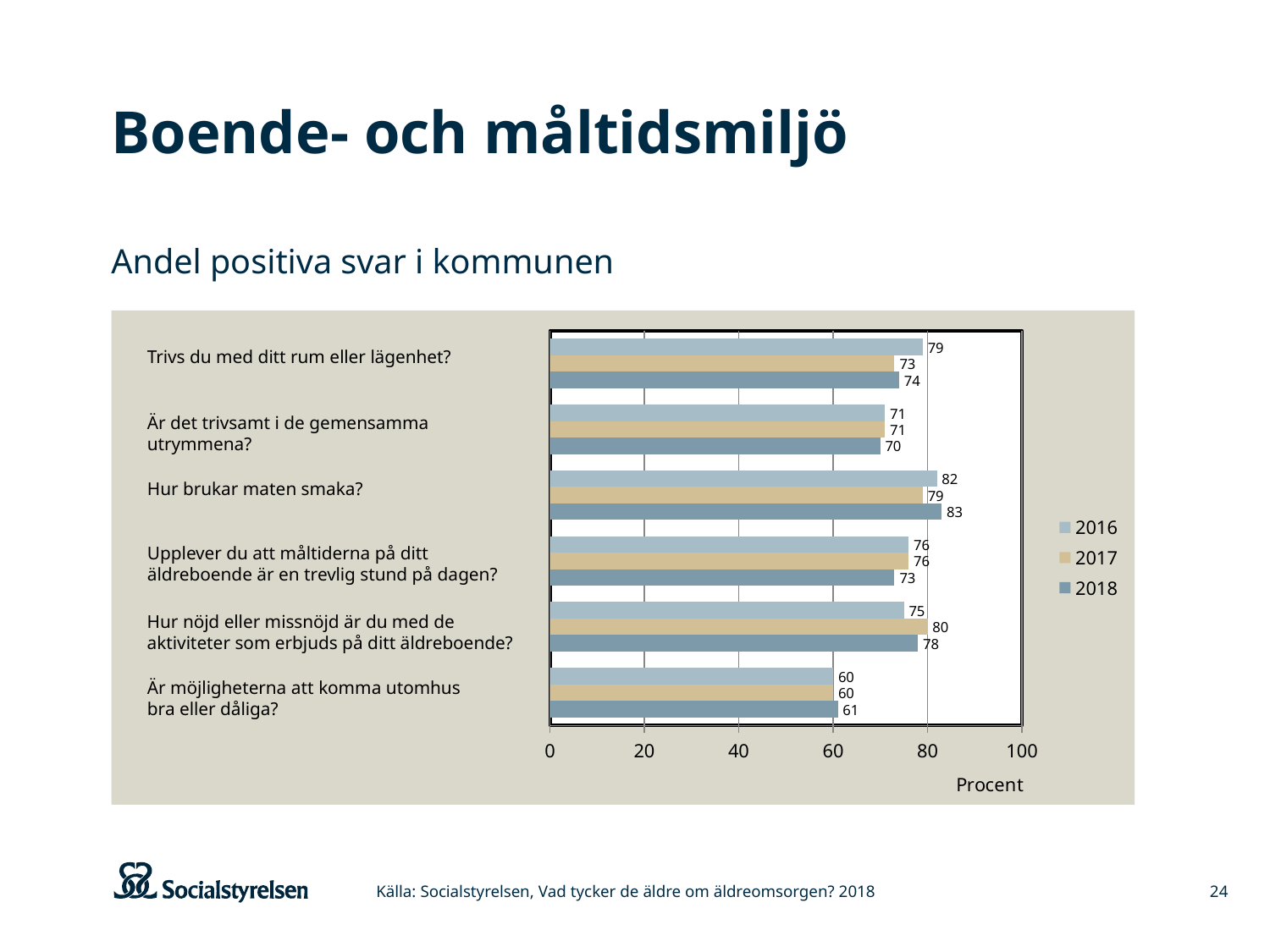
What is the label on the horizontal axis of the chart? Procent What kind of chart is shown on the slide? bar chart What is the difference between the 2016 and 2017 values for "Trivs du med ditt rum eller lägenhet?"? 6 What is the 2017 value for "Hur nöjd eller missnöjd är du med de aktiviteter som erbjuds på ditt äldreboende?"? 80 Which category has the lowest 2018 value? Är möjligheterna att komma utomhus bra eller dåliga? Is the 2018 value for "Är möjligheterna att komma utomhus bra eller dåliga?" greater or less than 80? less How many categories (questions) are shown in the chart? 6 Which category has the highest 2016 value? Hur brukar maten smaka? What is the 2016 value for "Trivs du med ditt rum eller lägenhet?"? 79 How many series does the legend list? 3 For "Upplever du att måltiderna på ditt äldreboende är en trevlig stund på dagen?", which is larger: the 2016 value or the 2018 value? 2016 What is the 2018 value for "Hur brukar maten smaka?"? 83